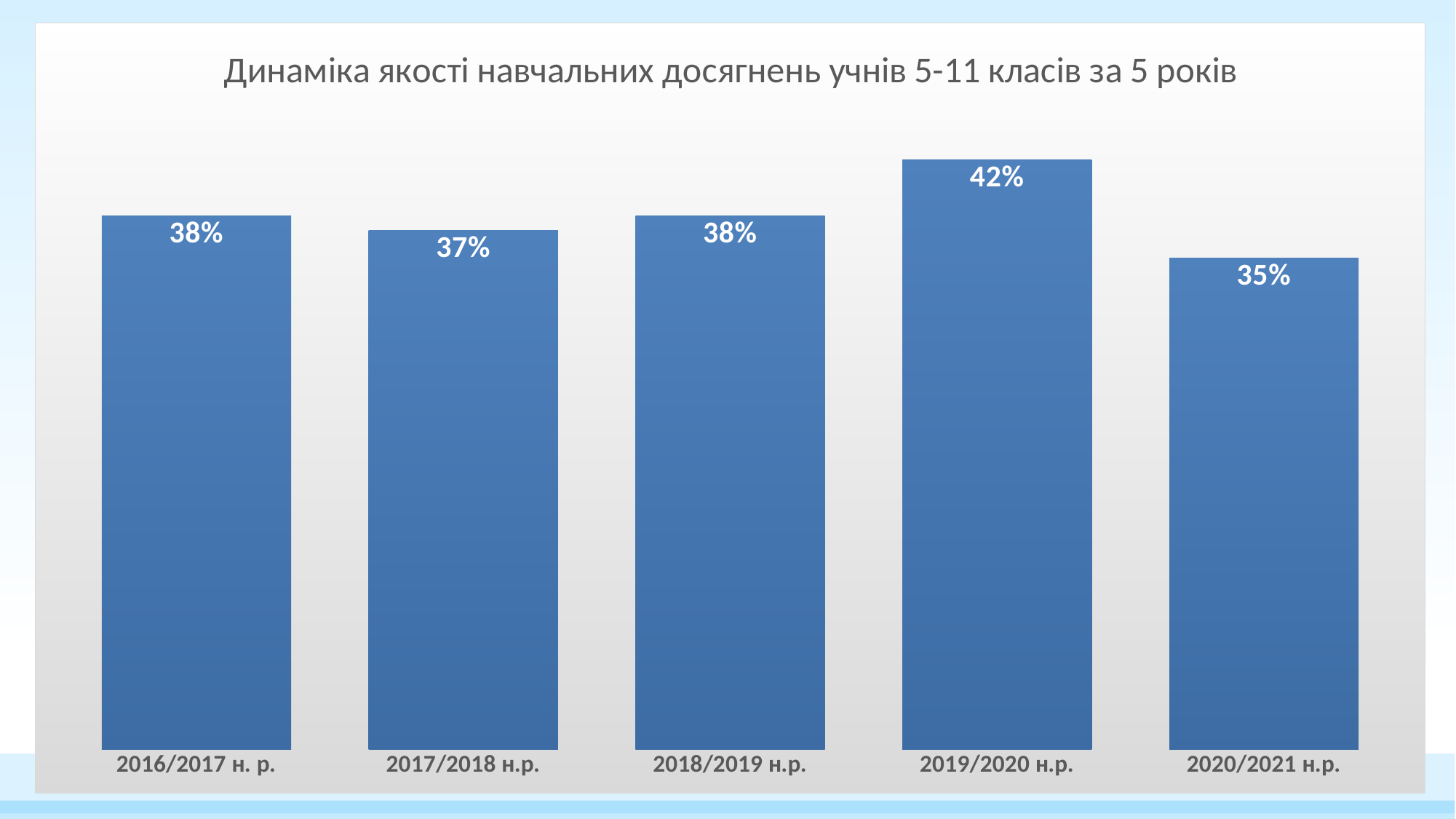
How many school years are shown on the chart? 5 What is the value for 2020/2021 н.р.? 35% Which school year has the lowest value? 2020/2021 н.р. What is the value for 2017/2018 н.р.? 37% What is the difference between the values for 2018/2019 н.р. and 2017/2018 н.р.? 1% What is the difference between the values for 2019/2020 н.р. and 2020/2021 н.р.? 7% What is the title of the chart? Динаміка якості навчальних досягнень учнів 5-11 класів за 5 років Which school year has the highest value? 2019/2020 н.р. What is the value for 2016/2017 н. р.? 38% What kind of chart is shown on the slide? Bar chart Which is larger, the value for 2019/2020 н.р. or the value for 2016/2017 н. р.? 2019/2020 н.р. What is the value for 2019/2020 н.р.? 42%